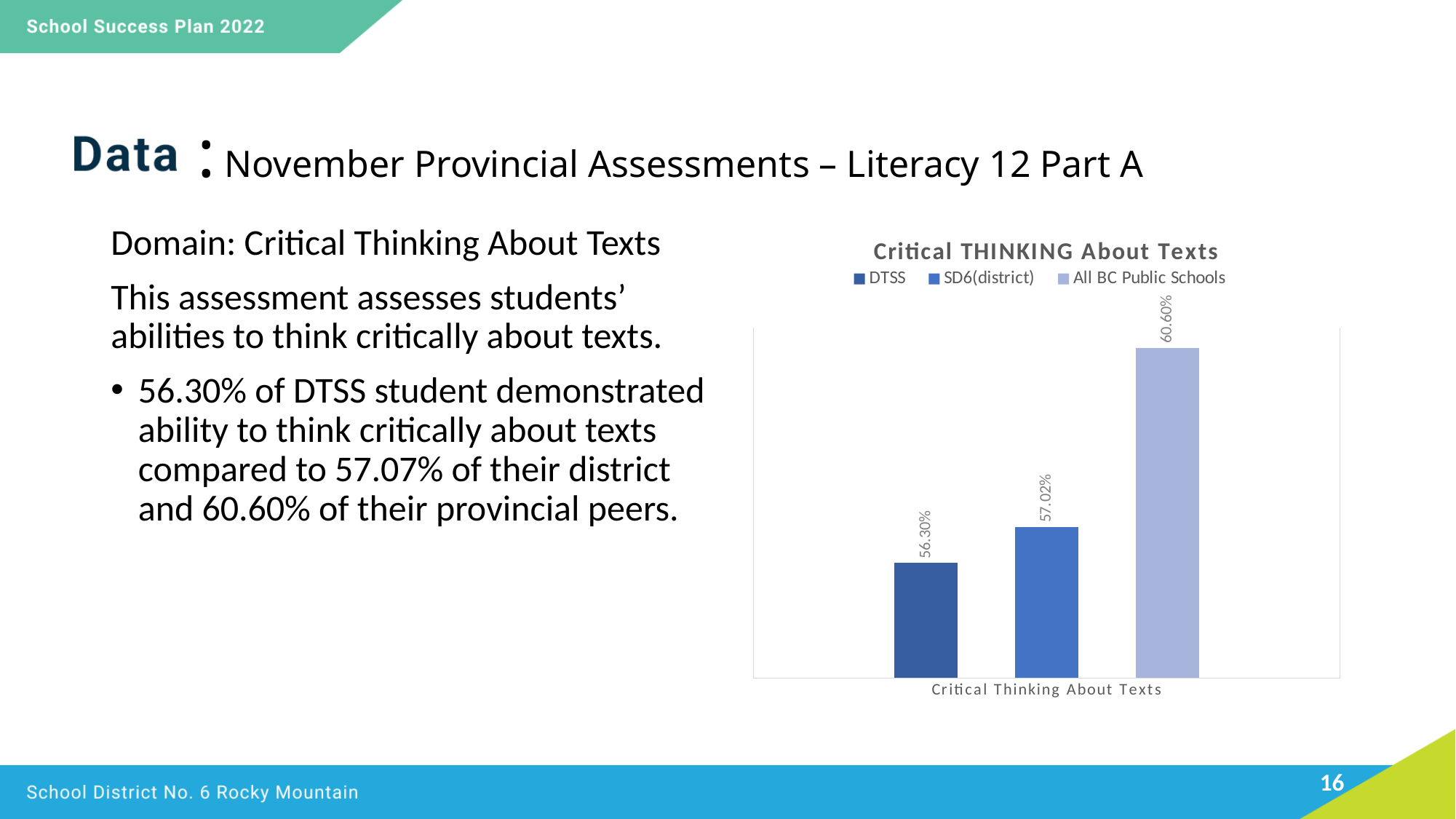
What is the value for SD6(district) in the chart? 57.02% What is the difference between the SD6(district) value and the DTSS value? 0.72% What kind of chart is shown on the slide? Bar chart Which series has the highest value in the chart? All BC Public Schools What is the title of the chart? Critical THINKING About Texts What is the value for All BC Public Schools in the chart? 60.60% Which series has the lowest value in the chart? DTSS Which is larger, the value for SD6(district) or the value for All BC Public Schools? All BC Public Schools How many categories are shown on the x axis of the chart? 1 What is the difference between the All BC Public Schools value and the DTSS value? 4.30% How many series does the legend list? 3 What is the value for DTSS in the chart? 56.30%